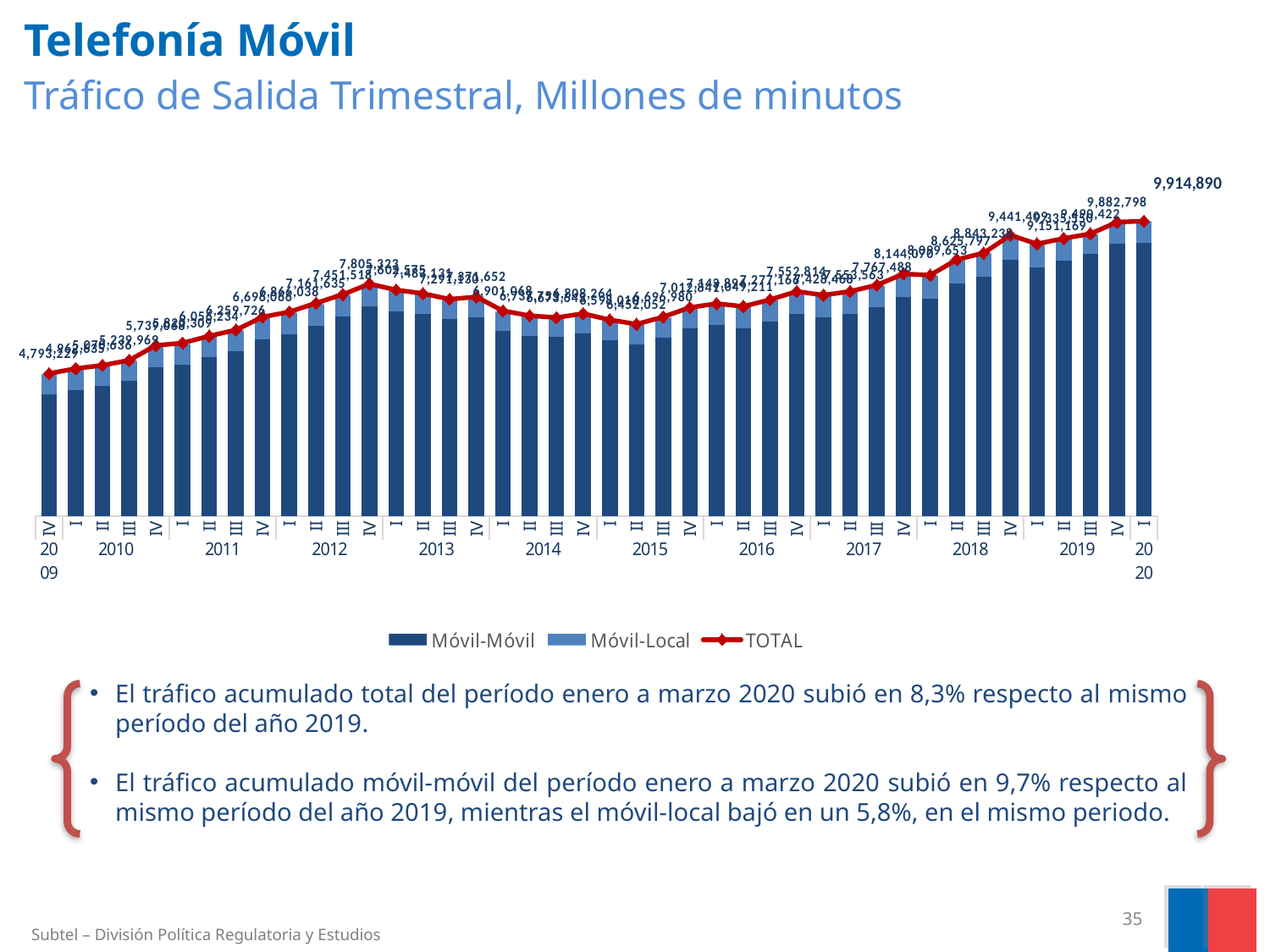
Which two series are shown as stacked bars? Móvil-Móvil and Móvil-Local Which is larger, the TOTAL for IV 2018 or the TOTAL for I 2019? IV 2018 What is the TOTAL value for I 2020? 9,914,890 What is the TOTAL value for IV 2019? 9,882,798 What is the difference between the TOTAL for I 2020 and the TOTAL for IV 2009? 5,121,661 Which quarter has the highest TOTAL value? I 2020 How many series does the legend list? 3 Which quarter has the lowest TOTAL value? IV 2009 What is the TOTAL value for IV 2012? 7,805,323 What kind of chart is shown? Stacked bar chart with a line Does the TOTAL line generally rise or fall from IV 2009 to I 2020? Rise What is the TOTAL value for the first quarter shown (IV 2009)? 4,793,229